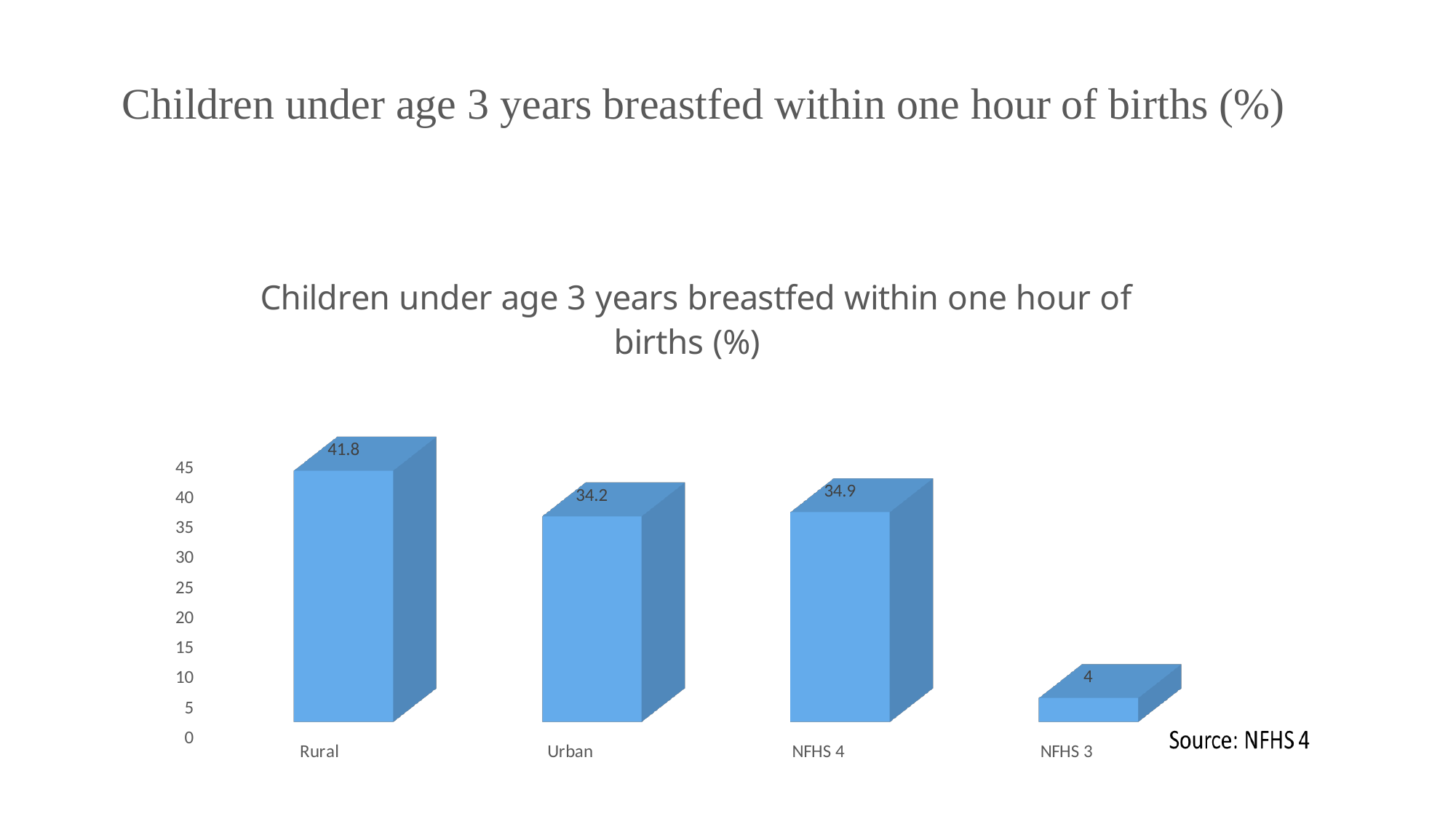
What is the value for Urban? 34.2 Which category has the lowest value? NFHS 3 What is the value for Rural? 41.8 What is the value for NFHS 3? 4 What is the difference between the values for Rural and Urban? 7.6 What kind of chart is shown on the slide? Bar chart Which is larger, the value for Rural or the value for NFHS 4? Rural Which category has the highest value? Rural How many categories are shown on the x axis? 4 What is the title of the chart? Children under age 3 years breastfed within one hour of births (%) What is the value for NFHS 4? 34.9 What is the difference between the values for NFHS 4 and NFHS 3? 30.9